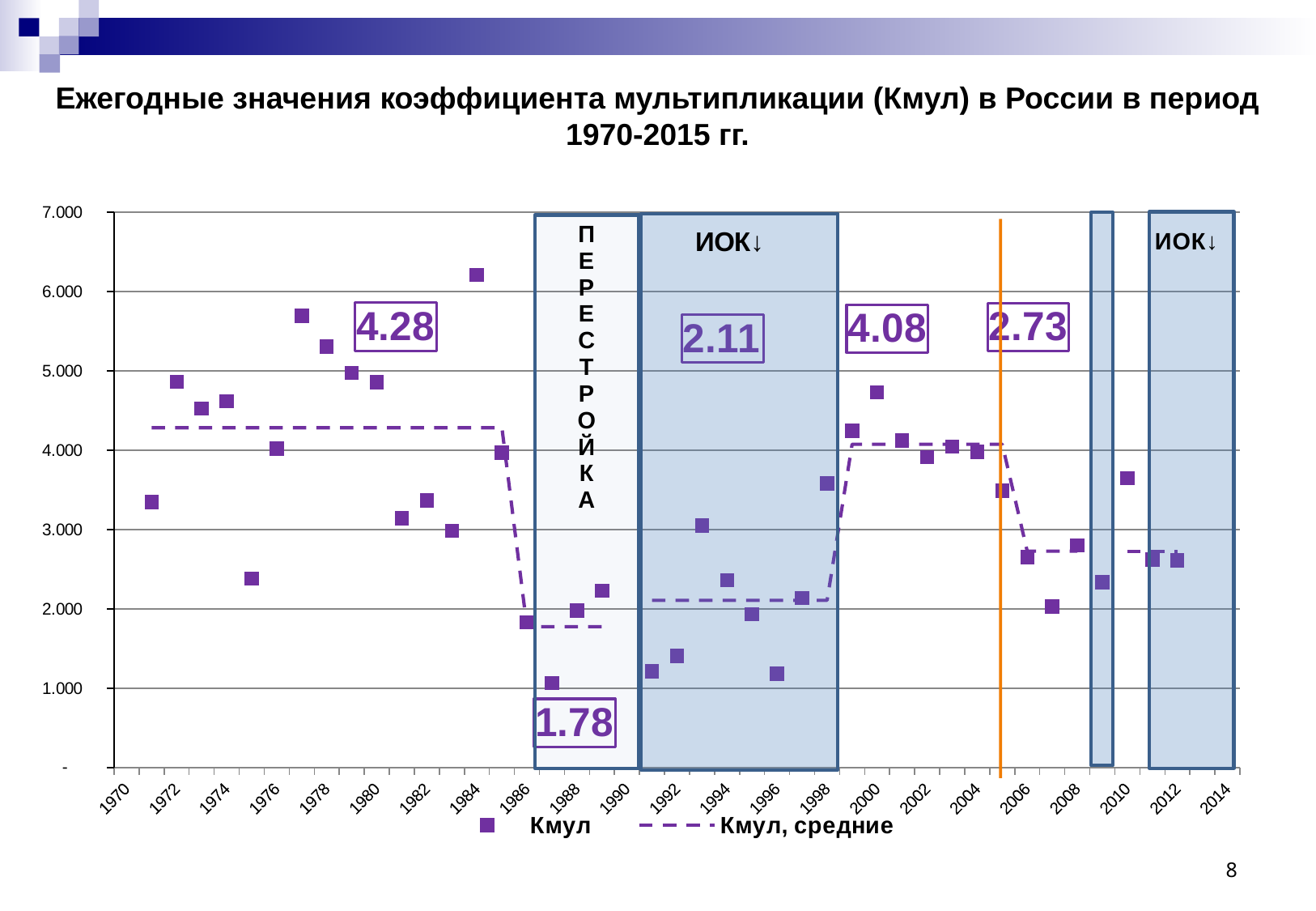
What average value is printed in the box inside the first ИОК↓ band (1990s)? 2.11 Which printed period average is the highest? 4.28 Which printed period average is the lowest? 1.78 Is the Кмул value for 1992 greater or less than 2.000? less What are the two legend entries of the chart? Кмул; Кмул, средние What average value is printed in the box to the right of the orange vertical line? 2.73 What average value is printed in the box for the period around 2000–2004? 4.08 Is the Кмул value for 1984 greater or less than 6.000? greater What average value is printed in the box inside the Перестройка band? 1.78 What average value is printed in the box for the period before Перестройка (1970s–mid 1980s)? 4.28 What kind of chart is shown on the slide? scatter chart How many series does the legend list? 2